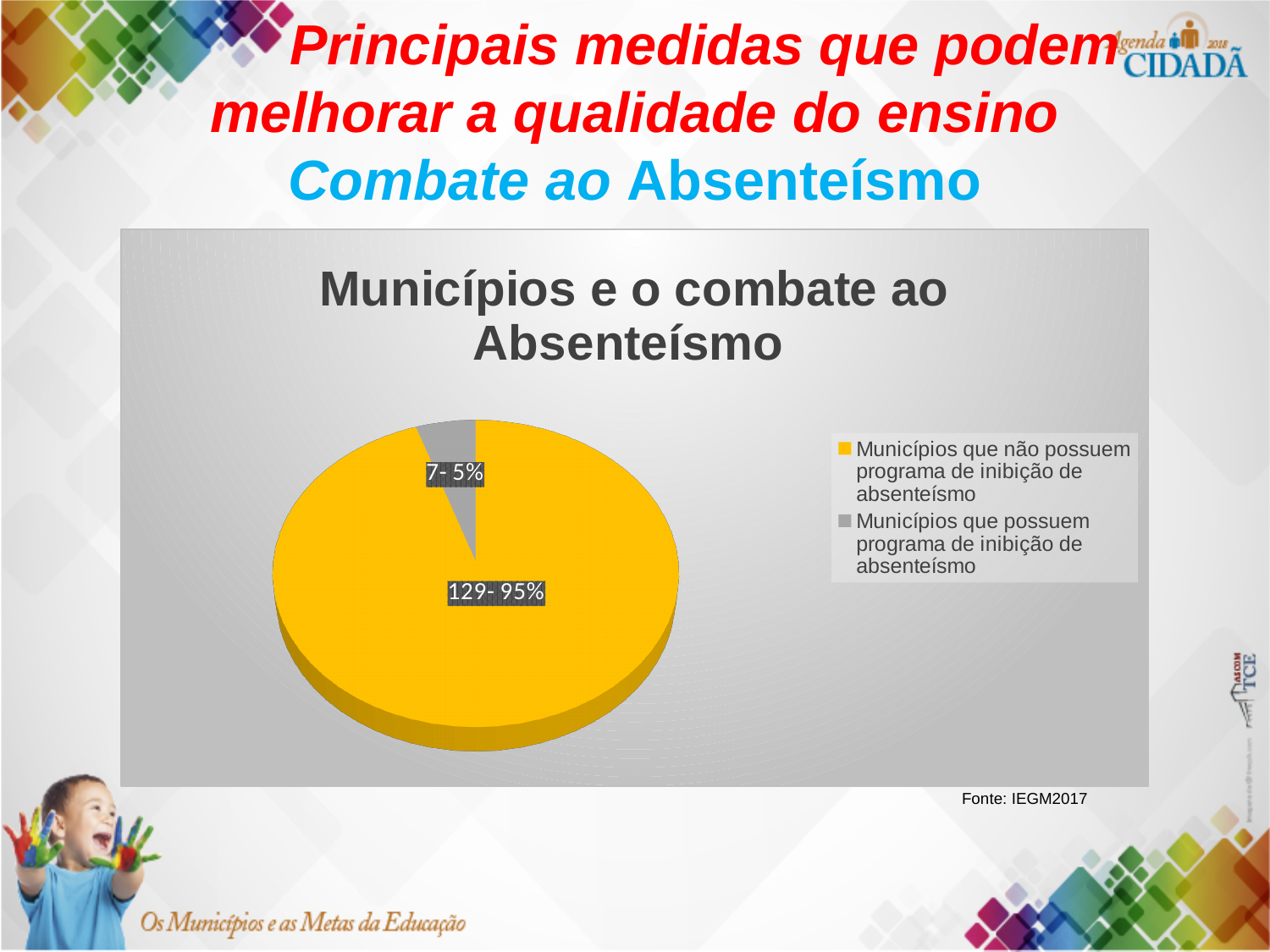
What share of the pie is taken by municipalities that have a programme to inhibit absenteeism? 5% Which category has the largest slice? Municípios que não possuem programa de inibição de absenteísmo What is the data label on the slice for 'Municípios que possuem programa de inibição de absenteísmo'? 7- 5% How many slices does the pie chart have? 2 What is the difference in the number of municipalities between those without and those with a programme to inhibit absenteeism? 122 What share of the pie is taken by municipalities that do not have a programme to inhibit absenteeism? 95% How many entries does the legend list? 2 What colour is the slice for 'Municípios que possuem programa de inibição de absenteísmo'? grey What kind of chart is shown on the slide? pie chart What is the data label on the slice for 'Municípios que não possuem programa de inibição de absenteísmo'? 129- 95% Which category has the smallest slice? Municípios que possuem programa de inibição de absenteísmo What is the title of the chart? Municípios e o combate ao Absenteísmo